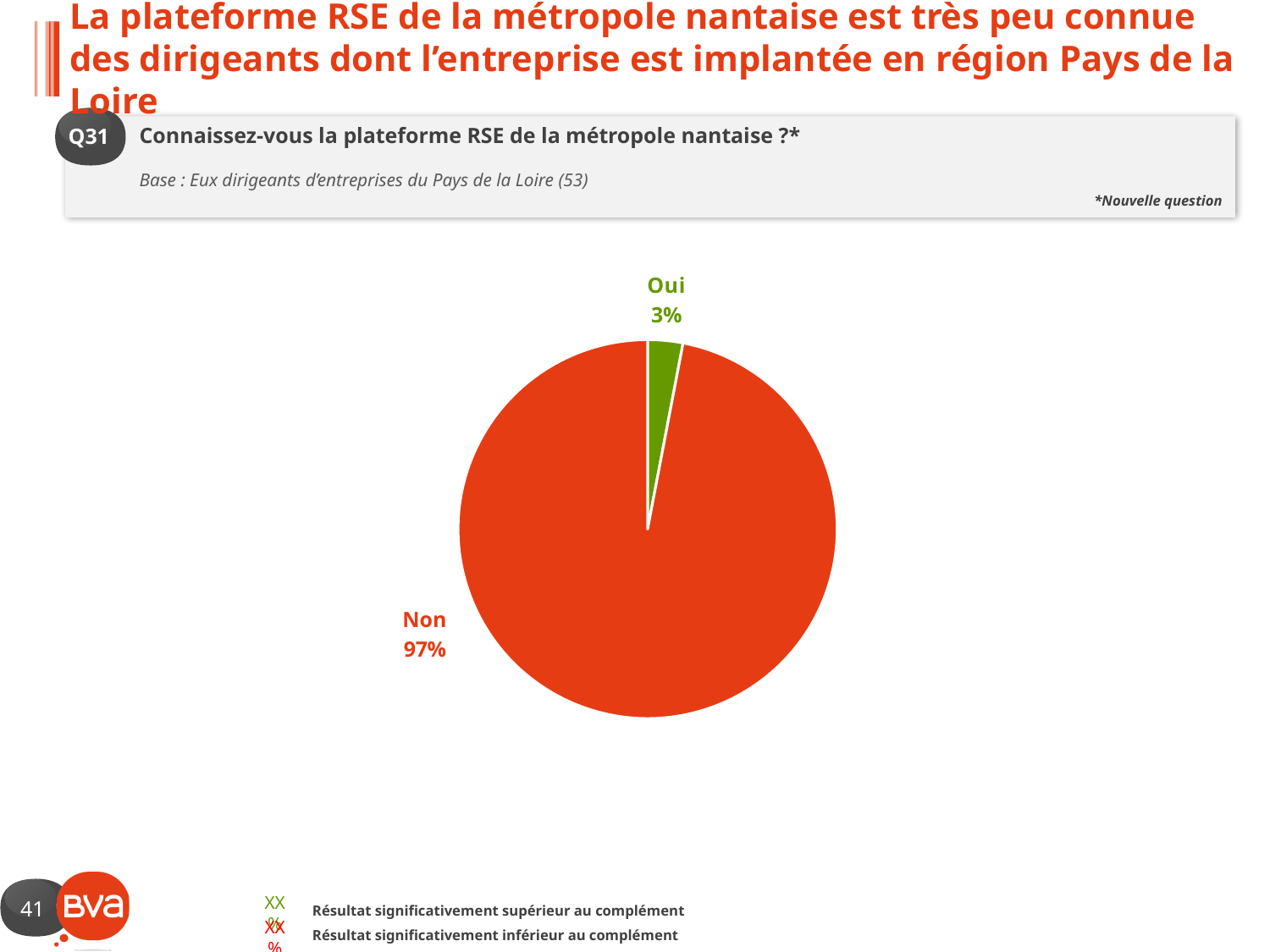
How many categories are shown in the pie chart? 2 Which is larger, the share for "Oui" or the share for "Non"? Non What is the difference in percentage points between "Non" and "Oui"? 94 What is the base (number of respondents) stated for this question? 53 What percentage of respondents answered "Non"? 97% What kind of chart is shown on the slide? Pie chart What percentage of respondents answered "Oui"? 3% Which category has the smallest share of the pie? Oui What share of the pie does the "Oui" slice represent? 3% What colour is the "Non" slice of the pie? Red/orange Which category has the largest share of the pie? Non